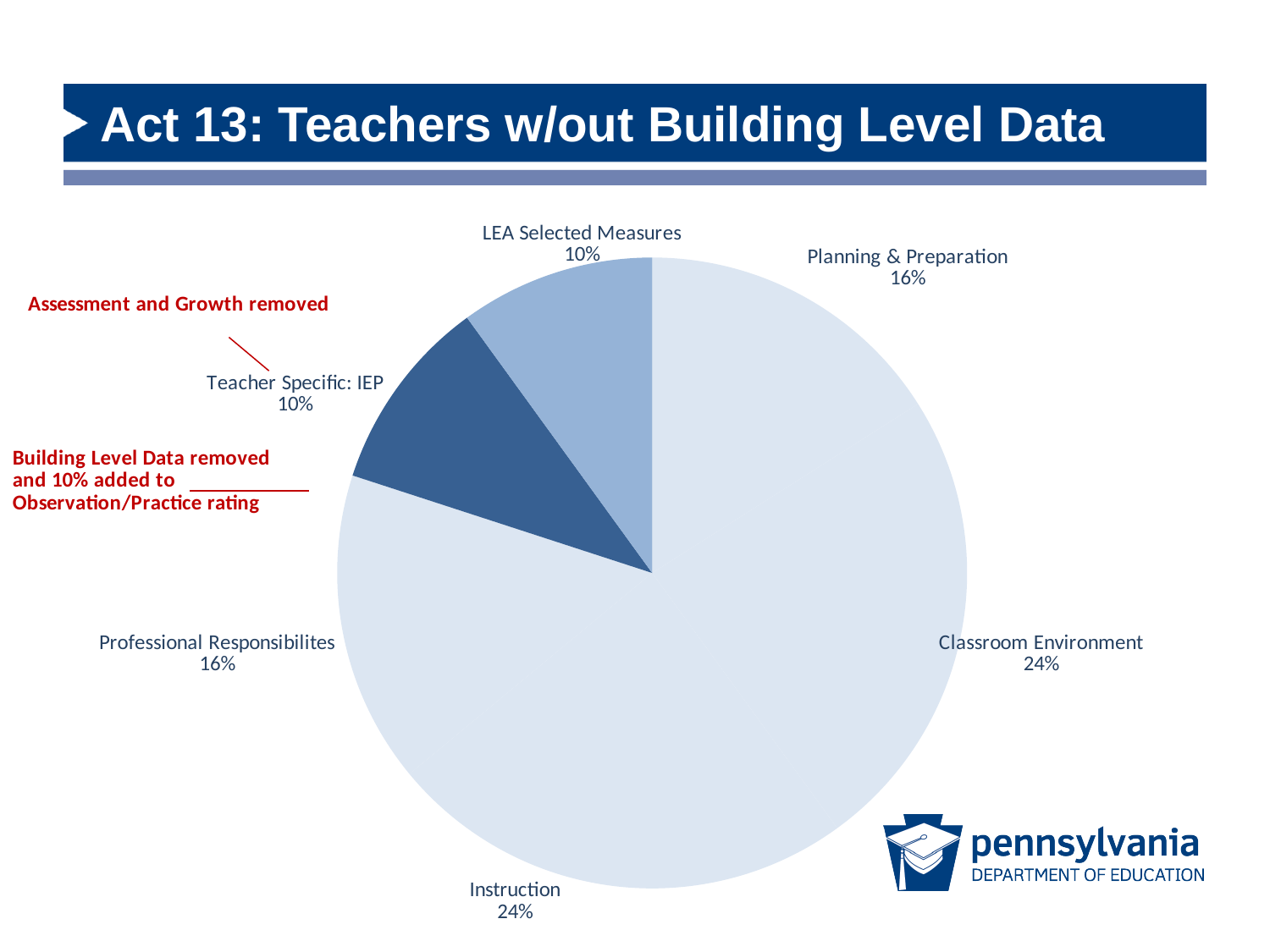
What kind of chart is shown on the slide? Pie chart What percentage is shown for Instruction? 24% What percentage is shown for Professional Responsibilites? 16% What percentage is shown for Classroom Environment? 24% What percentage is shown for Teacher Specific: IEP? 10% What percentage is shown for Planning & Preparation? 16% What is the combined share of Instruction and Classroom Environment? 48% What is the title of the slide containing the pie chart? Act 13: Teachers w/out Building Level Data Which is larger, Instruction or Planning & Preparation? Instruction What is the difference between the Classroom Environment share and the LEA Selected Measures share? 14% What percentage is shown for LEA Selected Measures? 10% How many slices does the pie chart have? 6